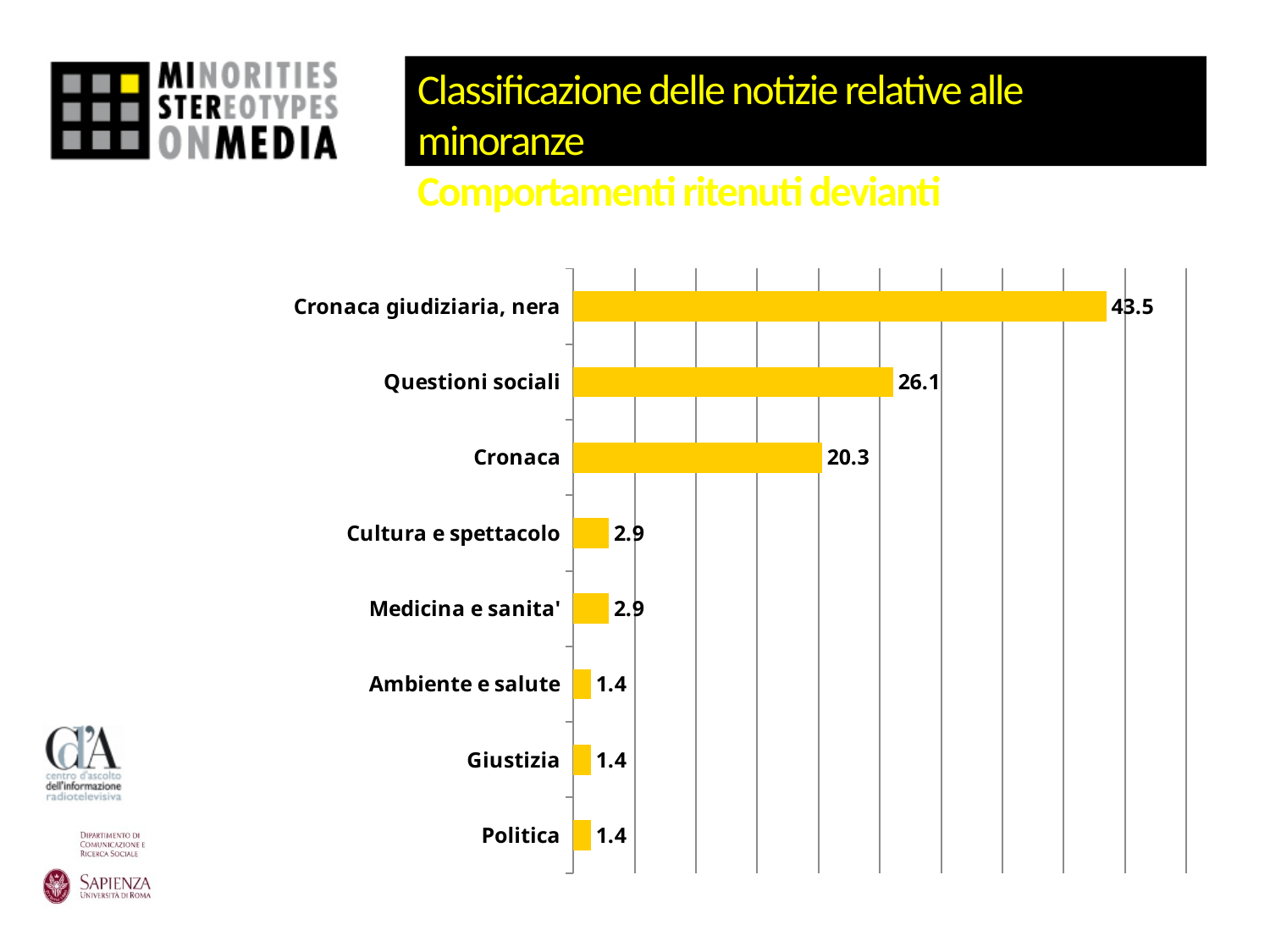
What is the value for Questioni sociali? 26.1 What kind of chart is shown on the slide? Bar chart What is the value for Politica? 1.4 What is the subtitle shown above the chart? Comportamenti ritenuti devianti What is the difference between the values for Cronaca giudiziaria, nera and Questioni sociali? 17.4 What is the value for Cronaca? 20.3 What is the value for Cultura e spettacolo? 2.9 What is the value for Cronaca giudiziaria, nera? 43.5 How many categories are shown in the chart? 8 Which is larger, the value for Cronaca or the value for Medicina e sanita'? Cronaca Which category has the highest value? Cronaca giudiziaria, nera What is the difference between the values for Questioni sociali and Cronaca? 5.8